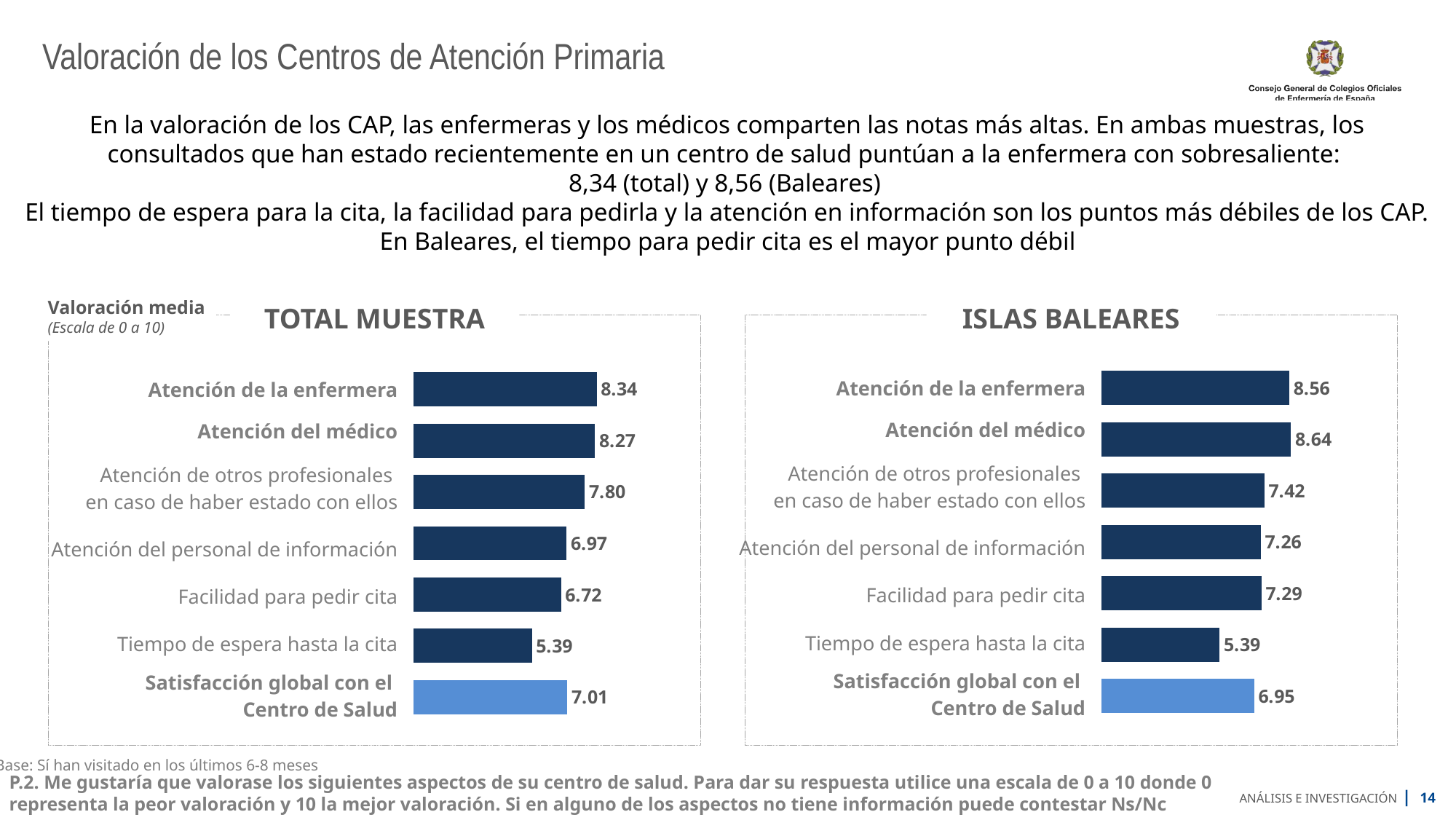
In the TOTAL MUESTRA chart, what is the value for Facilidad para pedir cita? 6.72 In the TOTAL MUESTRA chart, what is the difference between Atención de la enfermera and Tiempo de espera hasta la cita? 2.95 In the ISLAS BALEARES chart, what is the value for Satisfacción global con el Centro de Salud? 6.95 In the TOTAL MUESTRA chart, which bar is shown in a lighter blue colour than the others? Satisfacción global con el Centro de Salud In the TOTAL MUESTRA chart, how many categories are plotted? 7 In the ISLAS BALEARES chart, which is larger: Atención del médico or Atención de la enfermera? Atención del médico In the ISLAS BALEARES chart, what is the difference between Facilidad para pedir cita and Atención del personal de información? 0.03 In the ISLAS BALEARES chart, which category has the lowest value? Tiempo de espera hasta la cita In the TOTAL MUESTRA chart, which category has the highest value? Atención de la enfermera What kind of chart is the ISLAS BALEARES chart? Bar chart In the ISLAS BALEARES chart, what is the value for Atención del médico? 8.64 In the TOTAL MUESTRA chart, what is the value for Atención de la enfermera? 8.34